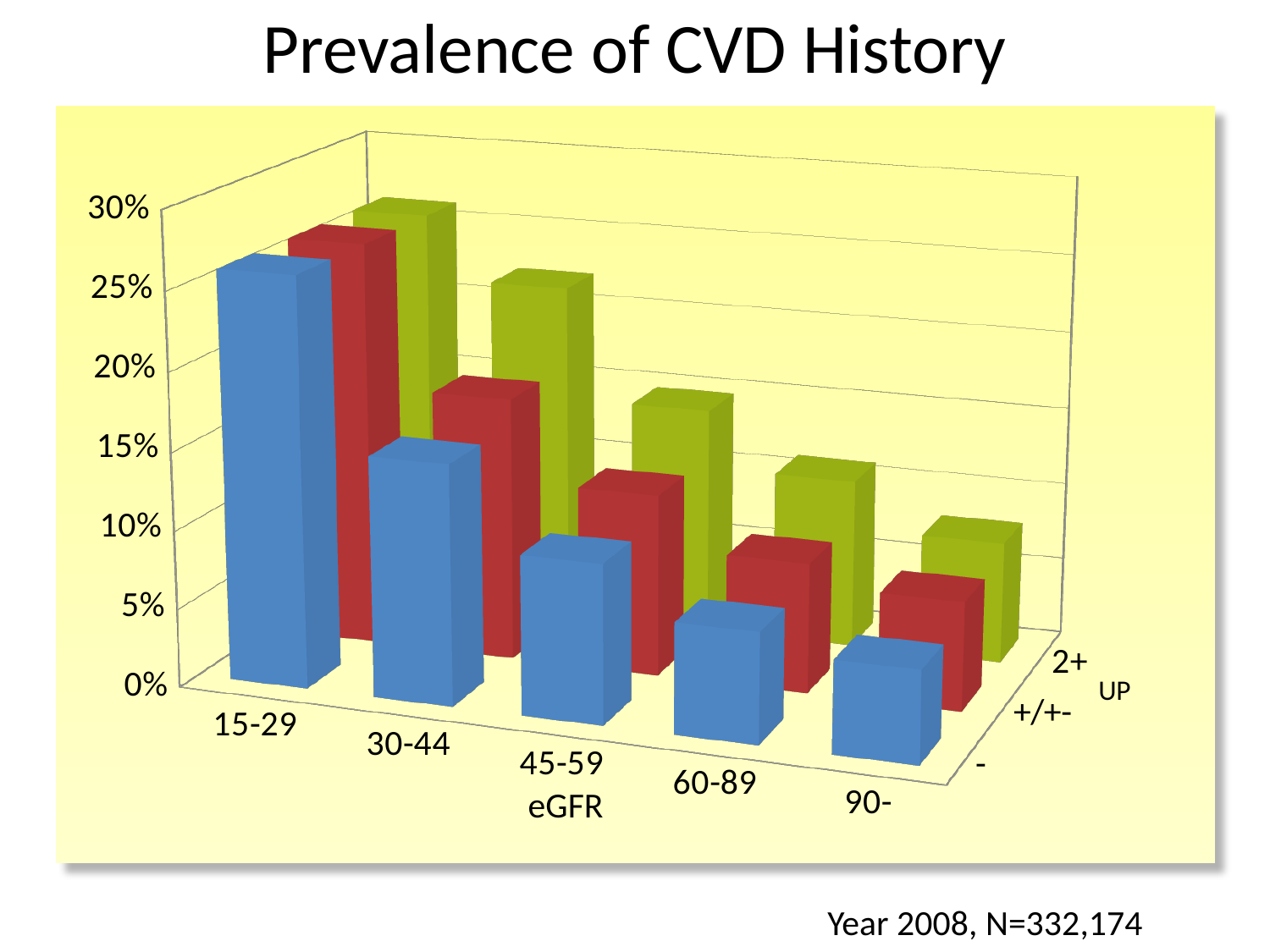
Do the values in the UP '-' series rise or fall as eGFR increases from 15-29 to 90-? fall Which eGFR category has the highest prevalence in the UP '-' series? 15-29 Is the value for eGFR 90- in the UP '-' series greater or less than 10%? less How many UP groups (series) are plotted in the chart? 3 How many eGFR categories are shown on the x axis? 5 What year and sample size are noted below the chart? Year 2008, N=332,174 What kind of chart is shown on the slide? bar chart In the UP '-' series, which is larger: the value for eGFR 15-29 or for eGFR 90-? 15-29 Which eGFR category has the lowest prevalence in the UP '-' series? 90- Is the value for eGFR 15-29 in the UP '-' series greater or less than 20%? greater Which eGFR category has the highest prevalence in the UP '2+' series? 15-29 What is the title of the chart? Prevalence of CVD History